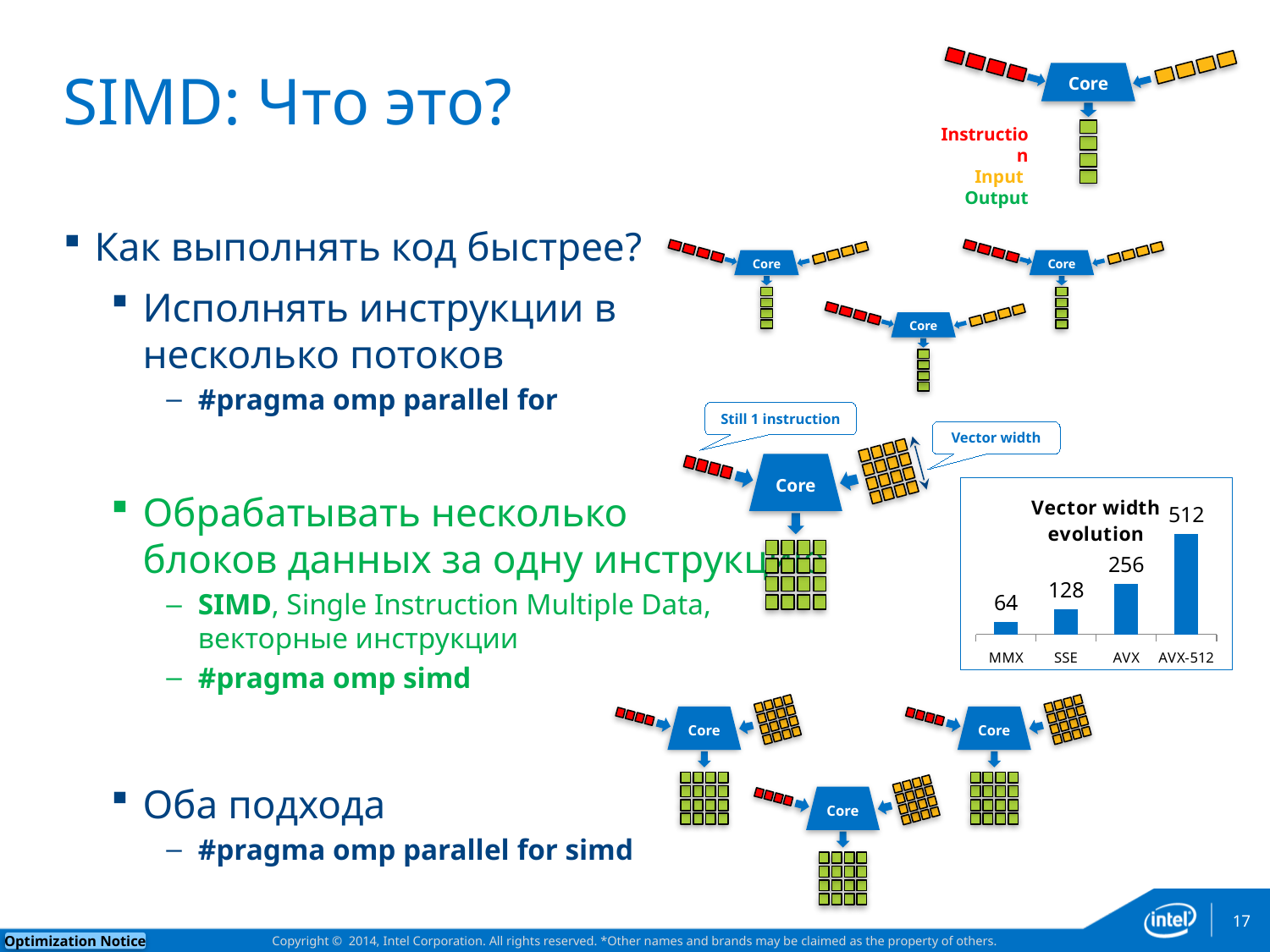
In the 'Vector width evolution' chart, which is larger: the value for SSE or the value for AVX? AVX In the 'Vector width evolution' chart, what is the value for SSE? 128 Which category has the lowest value in the 'Vector width evolution' chart? MMX In the 'Vector width evolution' chart, do the values rise or fall from MMX to AVX-512? rise What is the title of the chart on the slide? Vector width evolution In the 'Vector width evolution' chart, what is the difference between the values for AVX-512 and AVX? 256 Which category has the highest value in the 'Vector width evolution' chart? AVX-512 How many categories are shown in the 'Vector width evolution' chart? 4 In the 'Vector width evolution' chart, what is the value for MMX? 64 In the 'Vector width evolution' chart, what is the value for AVX? 256 In the 'Vector width evolution' chart, what is the value for AVX-512? 512 What type of chart is shown under the title 'Vector width evolution'? bar chart